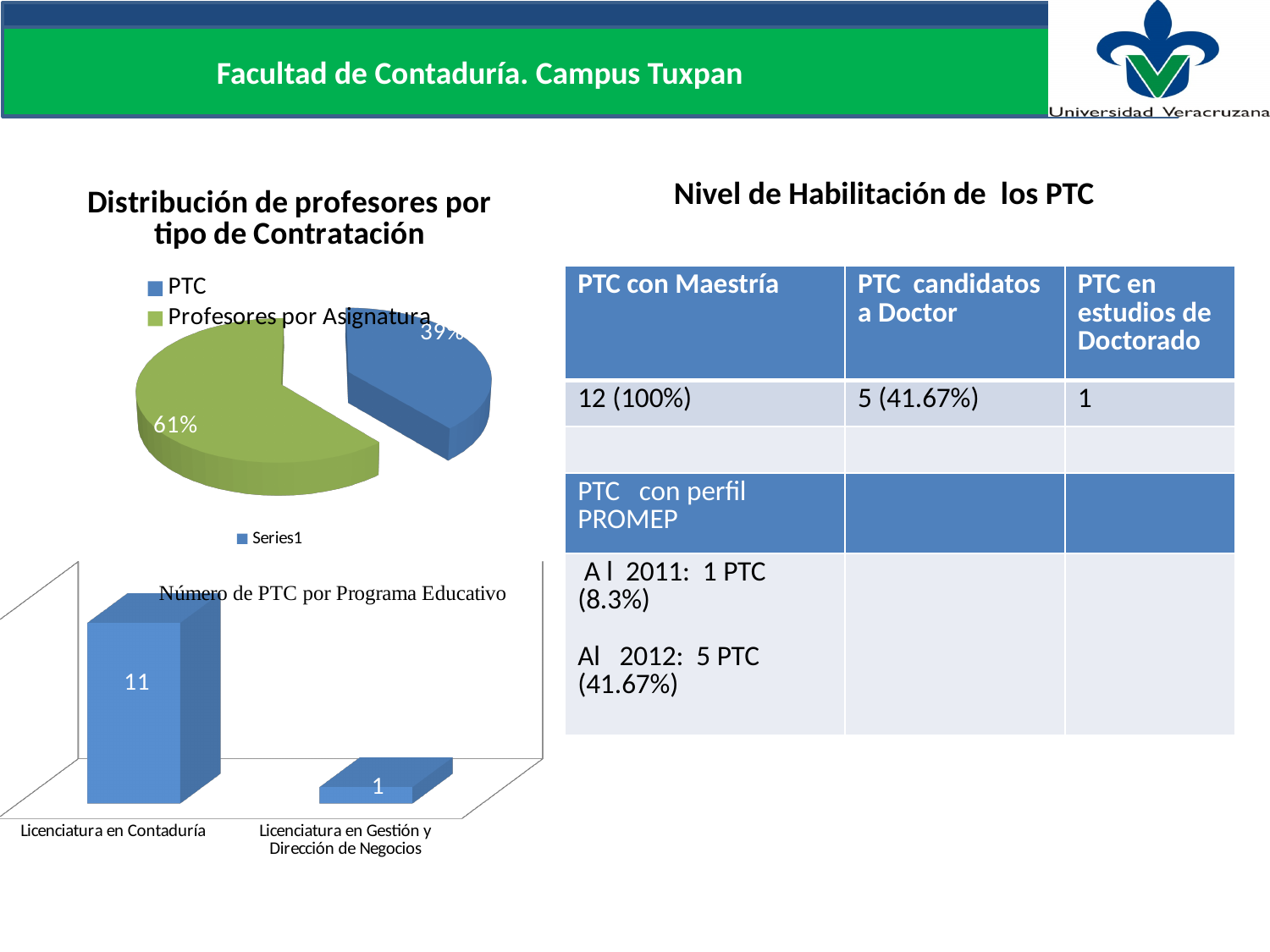
In the pie chart 'Distribución de profesores por tipo de Contratación', what share is shown for PTC? 39% In the pie chart 'Distribución de profesores por tipo de Contratación', how many categories does the legend list? 2 In the chart 'Número de PTC por Programa Educativo', what is the value for Licenciatura en Contaduría? 11 What kind of chart is 'Distribución de profesores por tipo de Contratación'? Pie chart In the chart 'Número de PTC por Programa Educativo', what is the difference between Licenciatura en Contaduría and Licenciatura en Gestión y Dirección de Negocios? 10 In the pie chart 'Distribución de profesores por tipo de Contratación', which category has the larger slice? Profesores por Asignatura In the chart 'Número de PTC por Programa Educativo', which program has the lowest number of PTC? Licenciatura en Gestión y Dirección de Negocios What kind of chart is 'Número de PTC por Programa Educativo'? Bar chart In the chart 'Número de PTC por Programa Educativo', what series name does the legend show? Series1 In the chart 'Número de PTC por Programa Educativo', what is the value for Licenciatura en Gestión y Dirección de Negocios? 1 In the pie chart 'Distribución de profesores por tipo de Contratación', what is the difference in percentage points between Profesores por Asignatura and PTC? 22 percentage points In the pie chart 'Distribución de profesores por tipo de Contratación', what share is shown for Profesores por Asignatura? 61%